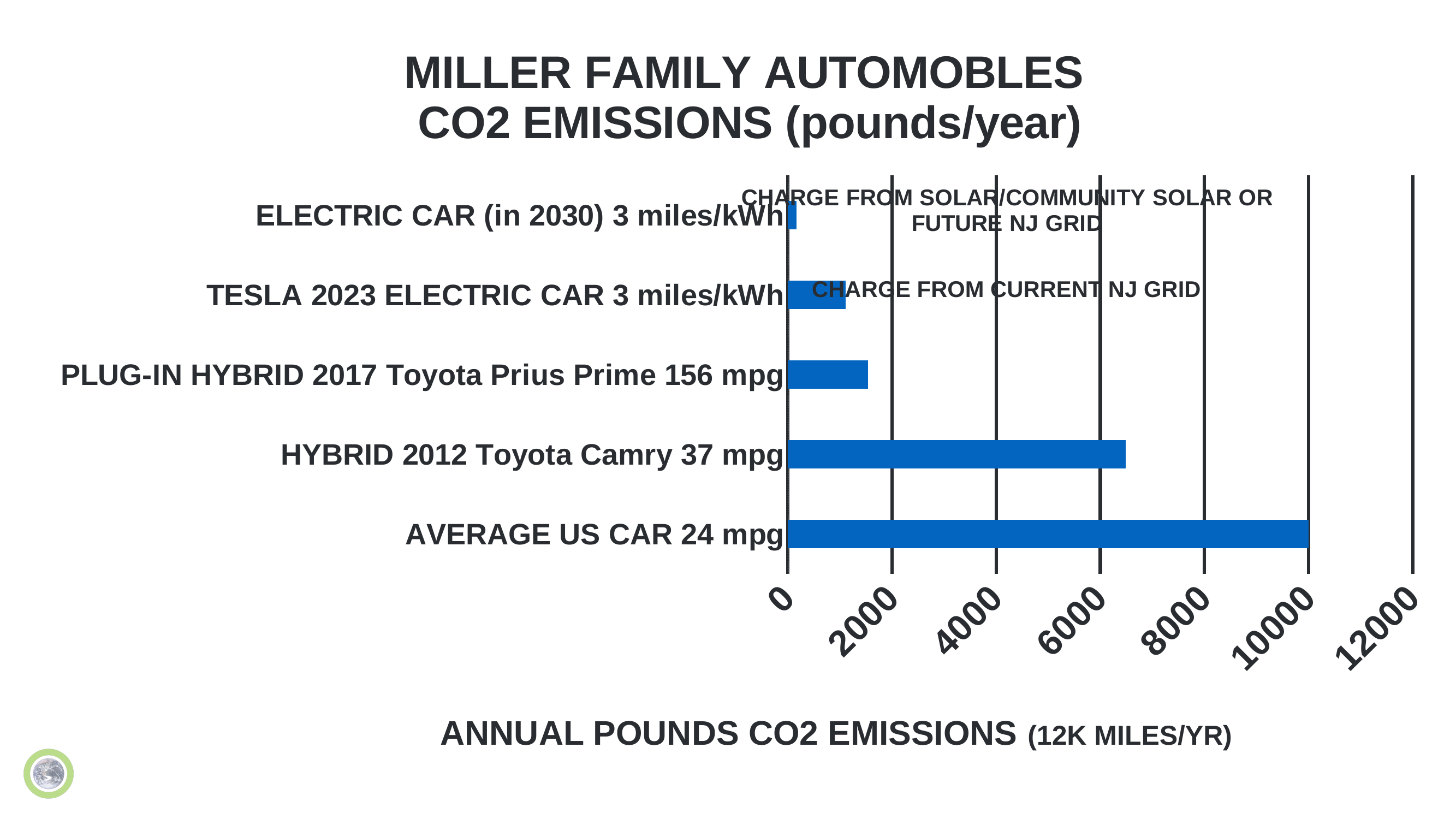
What is the annual CO2 emissions value for AVERAGE US CAR 24 mpg? 10000 Is the value for HYBRID 2012 Toyota Camry 37 mpg greater or less than 6000? greater What is the title of the chart? MILLER FAMILY AUTOMOBLES CO2 EMISSIONS (pounds/year) What kind of chart is shown on the slide? bar chart Which has higher CO2 emissions, HYBRID 2012 Toyota Camry 37 mpg or PLUG-IN HYBRID 2017 Toyota Prius Prime 156 mpg? HYBRID 2012 Toyota Camry 37 mpg Is the value for TESLA 2023 ELECTRIC CAR 3 miles/kWh greater or less than 2000? less How many vehicle categories are plotted in the chart? 5 Is the value for HYBRID 2012 Toyota Camry 37 mpg greater or less than 8000? less Which vehicle category has the lowest CO2 emissions in the chart? ELECTRIC CAR (in 2030) 3 miles/kWh Which vehicle category has the highest CO2 emissions in the chart? AVERAGE US CAR 24 mpg What is the label on the horizontal axis of the chart? ANNUAL POUNDS CO2 EMISSIONS (12K MILES/YR)